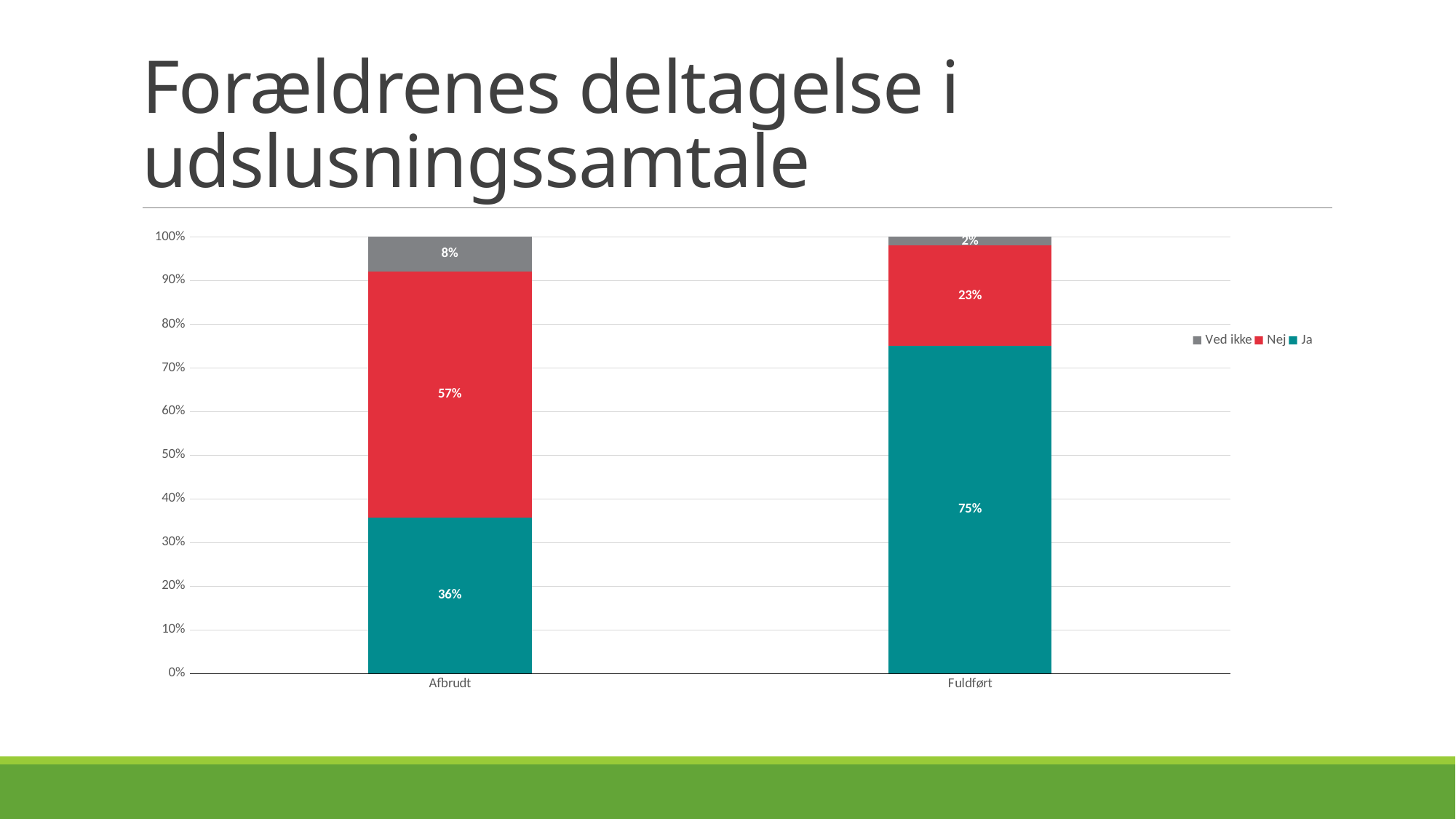
What is the value for Nej in the Fuldført bar? 23% What is the value for Ja in the Afbrudt bar? 36% What kind of chart is shown on the slide? Stacked bar chart Which category has the higher value for Nej, Afbrudt or Fuldført? Afbrudt What is the value for Ved ikke in the Afbrudt bar? 8% What is the value for Ja in the Fuldført bar? 75% What is the difference between the Nej values for Afbrudt and Fuldført? 34% Which series is shown in red? Nej What is the difference between the Ja values for Fuldført and Afbrudt? 39% Which category has the lower value for Ved ikke? Fuldført How many categories are shown on the x axis? 2 How many series does the legend list? 3